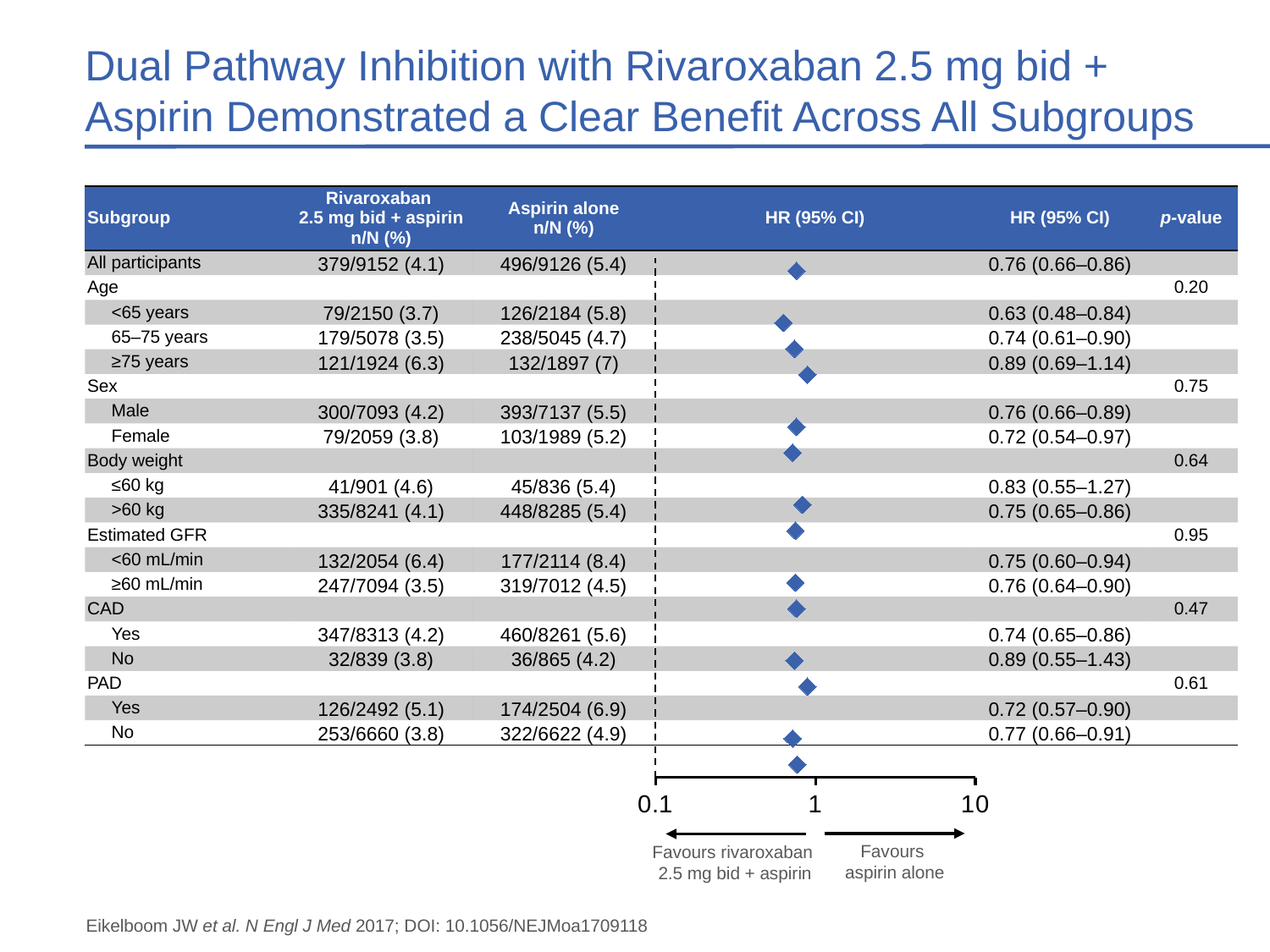
What are the tick values shown on the hazard ratio axis? 0.1, 1, 10 What is the difference between the hazard ratio point estimates for Male and Female? 0.04 Which has the larger hazard ratio point estimate, Male or Female? Male Which subgroup has the lowest hazard ratio point estimate? <65 years Is the hazard ratio point estimate for PAD Yes greater or less than 1? less What kind of chart is shown on the slide? Forest plot What does the arrow pointing left below the axis indicate? Favours rivaroxaban 2.5 mg bid + aspirin How many subgroup rows (excluding All participants) have a hazard ratio plotted? 13 Which subgroup category has the highest p-value? Estimated GFR What is the HR (95% CI) for All participants? 0.76 (0.66–0.86) What is the p-value shown for the Age subgroup? 0.20 What is the HR (95% CI) for the <65 years subgroup? 0.63 (0.48–0.84)